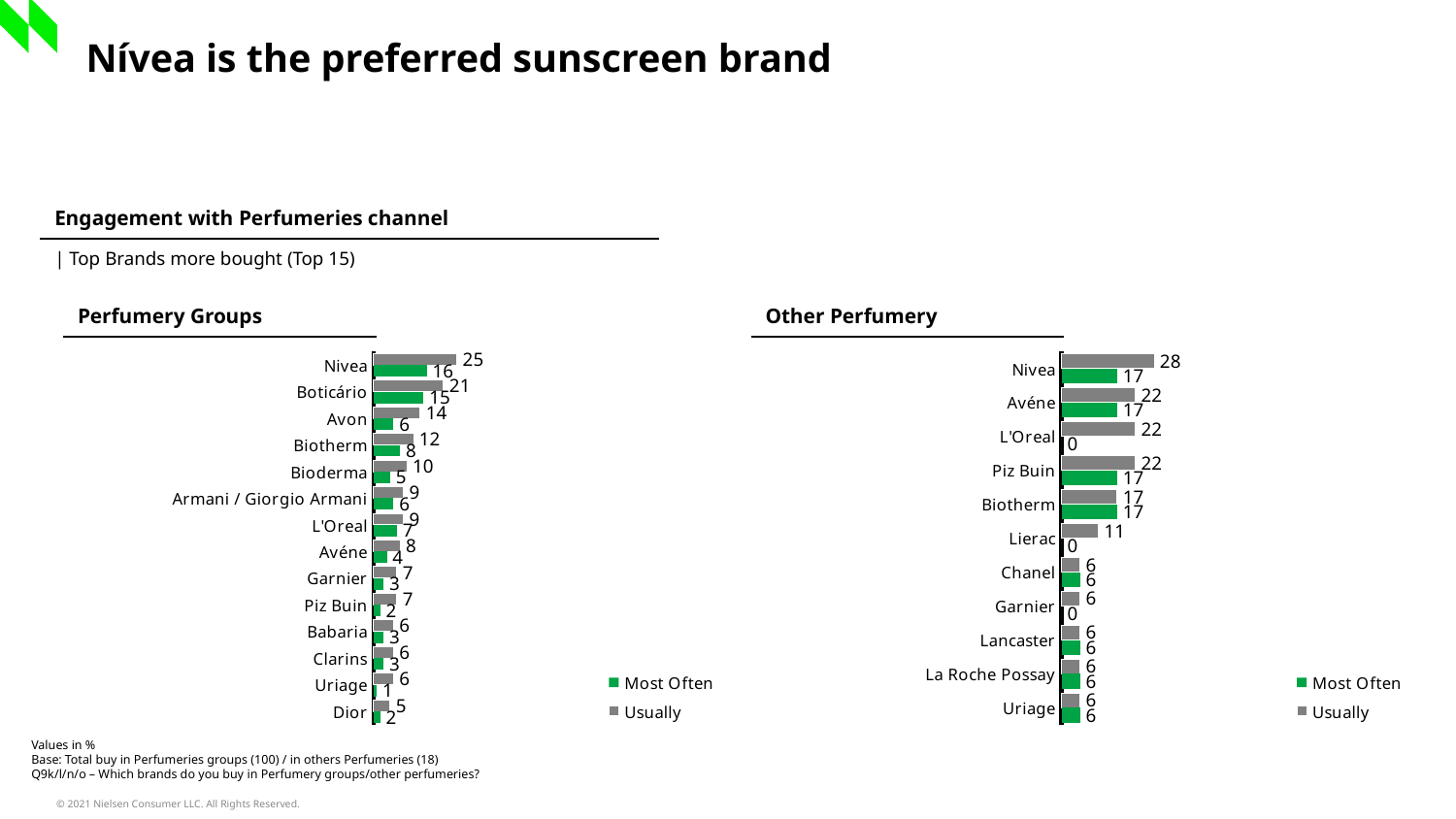
In the Perfumery Groups chart, what is the difference between the Usually values for Nivea and Boticário? 4 In the Perfumery Groups chart, what is the Usually value for Nivea? 25 In the Other Perfumery chart, what is the Usually value for Nivea? 28 What type of chart is the Perfumery Groups chart? Bar chart In the Other Perfumery chart, what is the Most Often value for L'Oreal? 0 How many brands are shown in the Other Perfumery chart? 11 In the Other Perfumery chart, what is the difference between the Usually and Most Often values for Lierac? 11 In the Perfumery Groups chart, what is the Most Often value for Boticário? 15 In the Other Perfumery chart, which brand has the highest Usually value? Nivea In the Perfumery Groups chart, which brand has the highest Usually value? Nivea In the Perfumery Groups chart, which is larger: the Most Often value for Avon or the Most Often value for Biotherm? Biotherm How many series does the legend of the Perfumery Groups chart list? 2